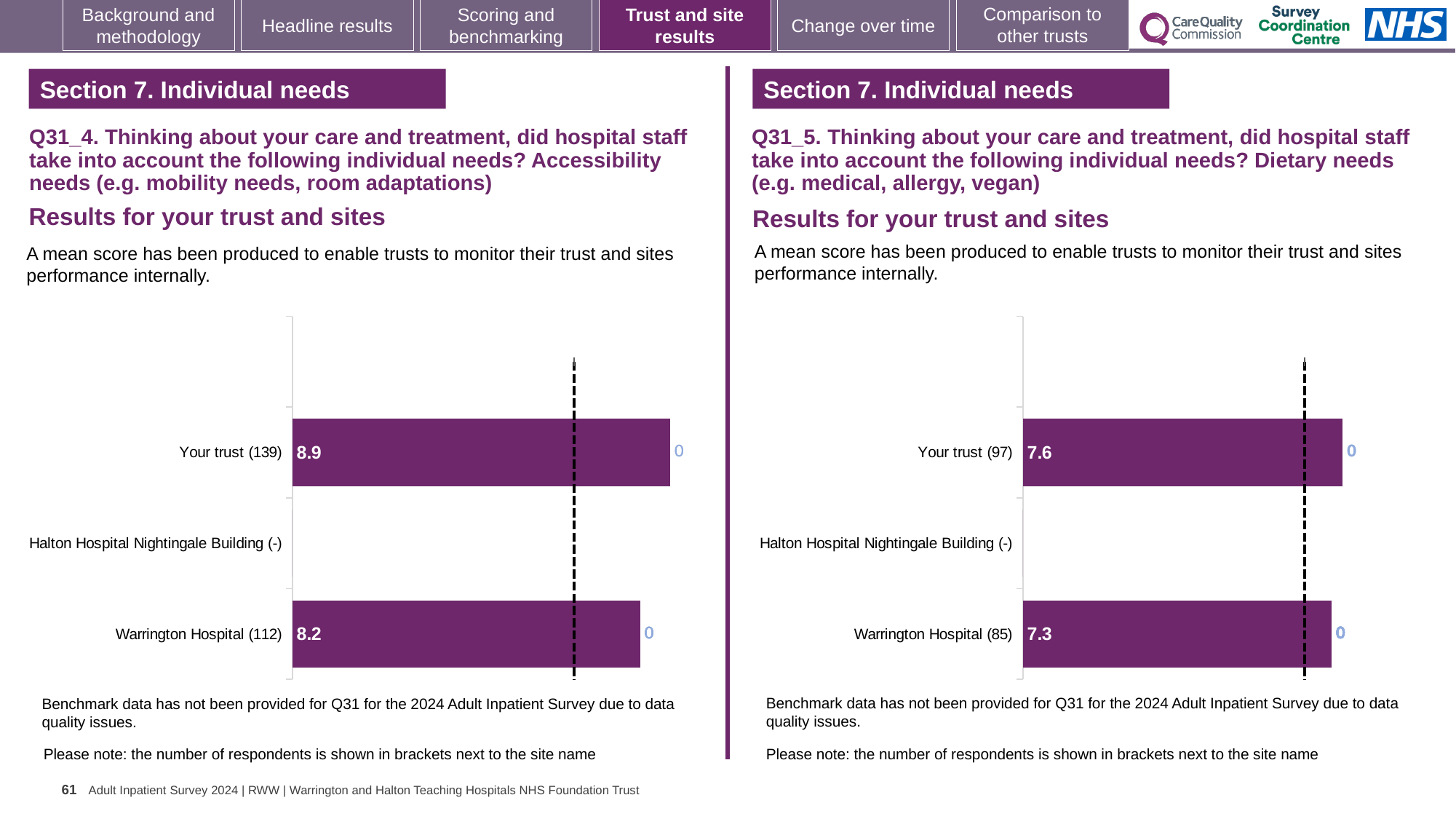
On the right chart (Q31_5, dietary needs), what is the mean score for Warrington Hospital? 7.3 On the right chart (Q31_5, dietary needs), how many respondents are shown in brackets for Warrington Hospital? 85 On the left chart (Q31_4, accessibility needs), what is the difference between the Your trust score and the Warrington Hospital score? 0.7 On the left chart (Q31_4, accessibility needs), which has the higher score: Your trust or Warrington Hospital? Your trust On the right chart (Q31_5, dietary needs), which has the lower score: Your trust or Warrington Hospital? Warrington Hospital On the left chart (Q31_4, accessibility needs), what is the mean score for Your trust? 8.9 On the left chart (Q31_4, accessibility needs), what is the mean score for Warrington Hospital? 8.2 On the right chart (Q31_5, dietary needs), what is the mean score for Your trust? 7.6 How many categories are listed on the vertical axis of the left chart (Q31_4, accessibility needs)? 3 On the right chart (Q31_5, dietary needs), what is the difference between the Your trust score and the Warrington Hospital score? 0.3 What type of chart is used on the right side of the slide (Q31_5, dietary needs)? Bar chart On the left chart (Q31_4, accessibility needs), which category has no bar plotted? Halton Hospital Nightingale Building (-)